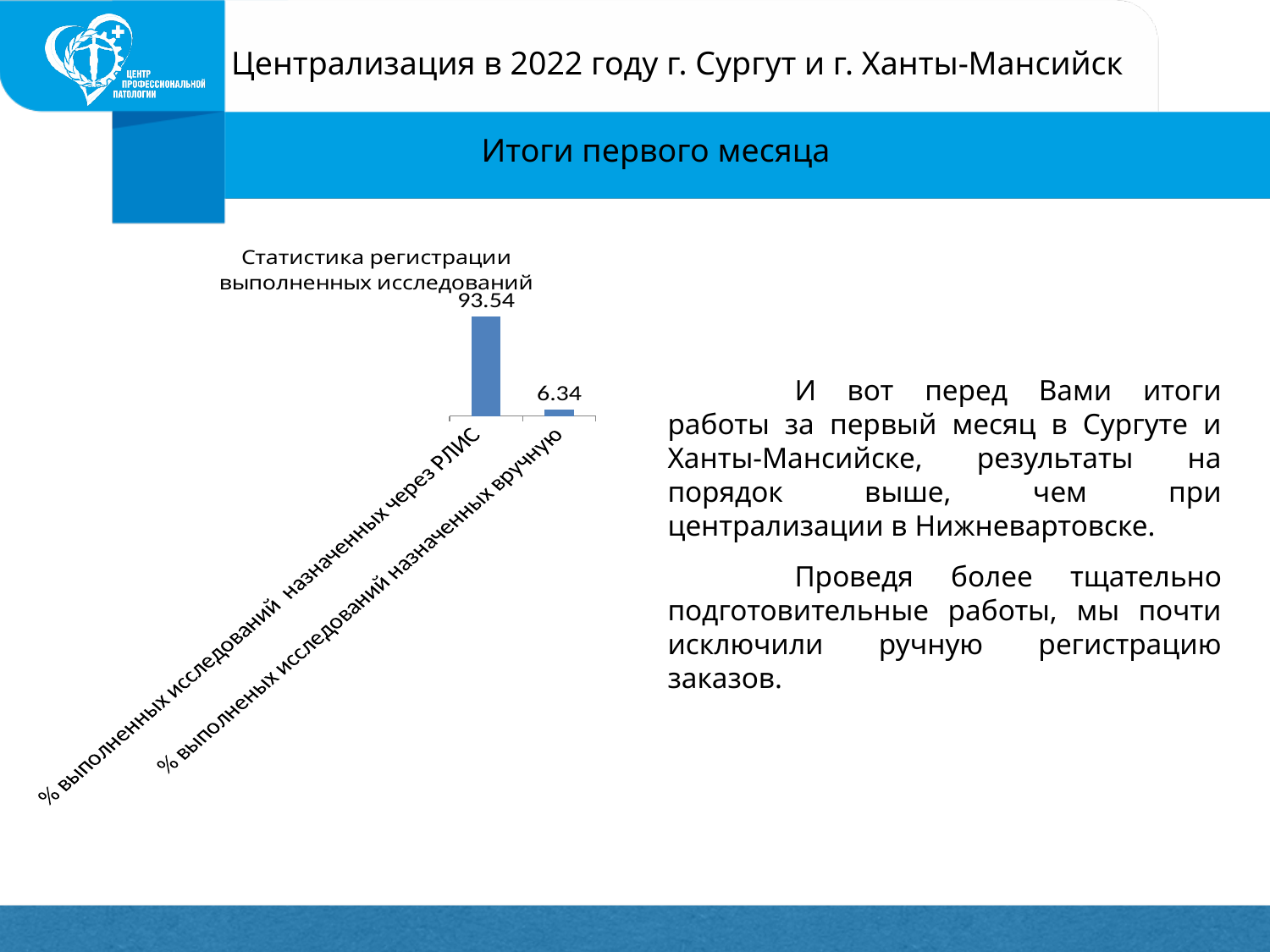
Which is larger: the value for studies assigned through РЛИС or the value for studies assigned manually (вручную)? % выполненных исследований назначенных через РЛИС What is the title of the chart? Статистика регистрации выполненных исследований Which category has the highest value? % выполненных исследований назначенных через РЛИС What is the value for '% выполненых исследований назначенных вручную'? 6.34 What is the difference between the value for studies assigned through РЛИС and the value for studies assigned manually (вручную)? 87.2 How many categories are shown in the chart? 2 What is the value for '% выполненных исследований назначенных через РЛИС'? 93.54 What kind of chart is shown on the slide? Bar chart Which category has the lowest value? % выполненых исследований назначенных вручную What is the total of the two values shown in the chart? 99.88